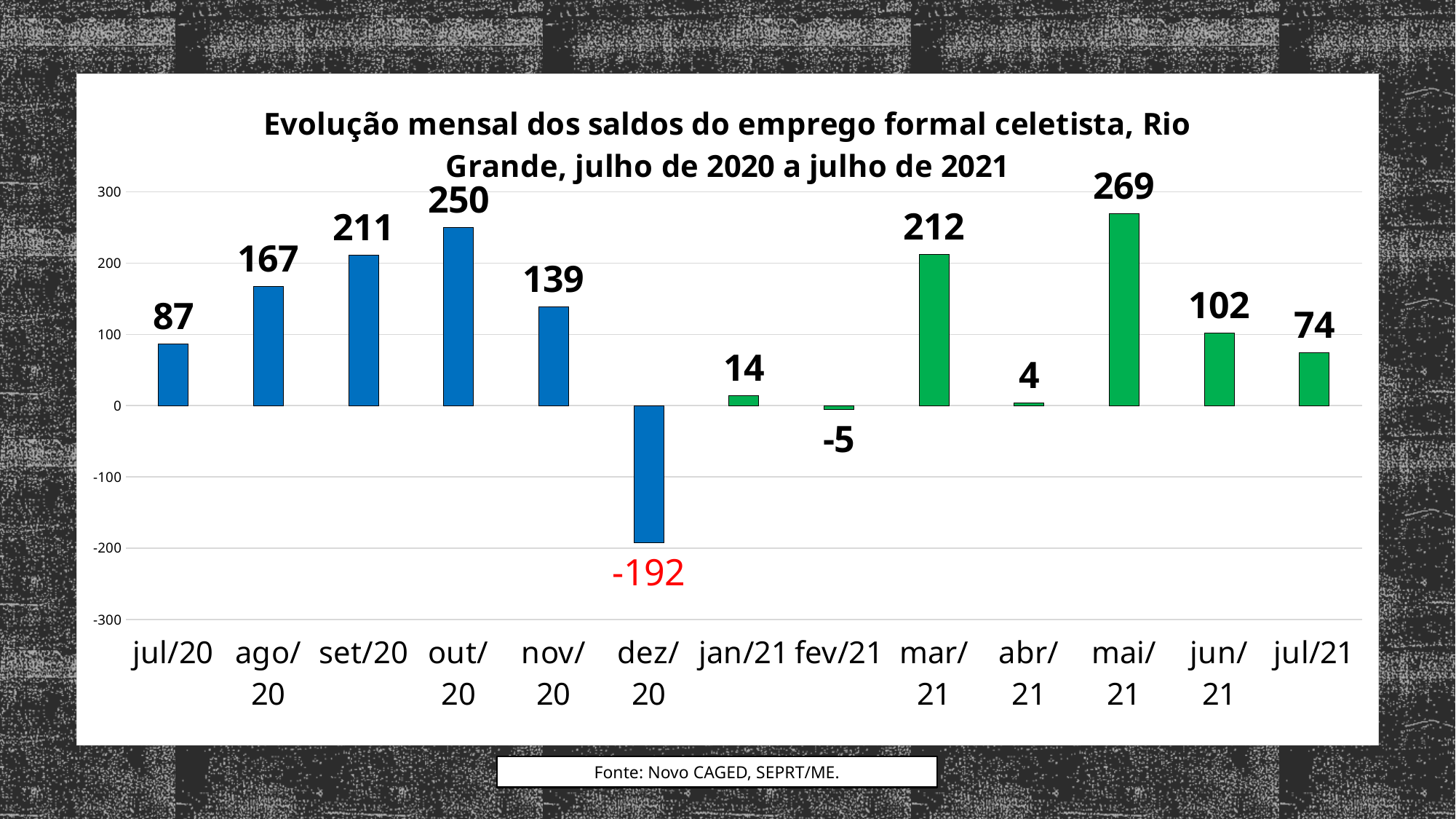
Which month has the lowest value? dez/20 What is the value for dez/20? -192 Which month has the highest value? mai/21 What is the value for jul/21? 74 What is the value for fev/21? -5 What is the source cited below the chart? Novo CAGED, SEPRT/ME. What kind of chart is this? bar chart How many months have a negative value? 2 What is the value for out/20? 250 How many months are shown on the x axis? 13 What is the difference between the values for mai/21 and mar/21? 57 Which is larger, the value for set/20 or the value for mar/21? mar/21